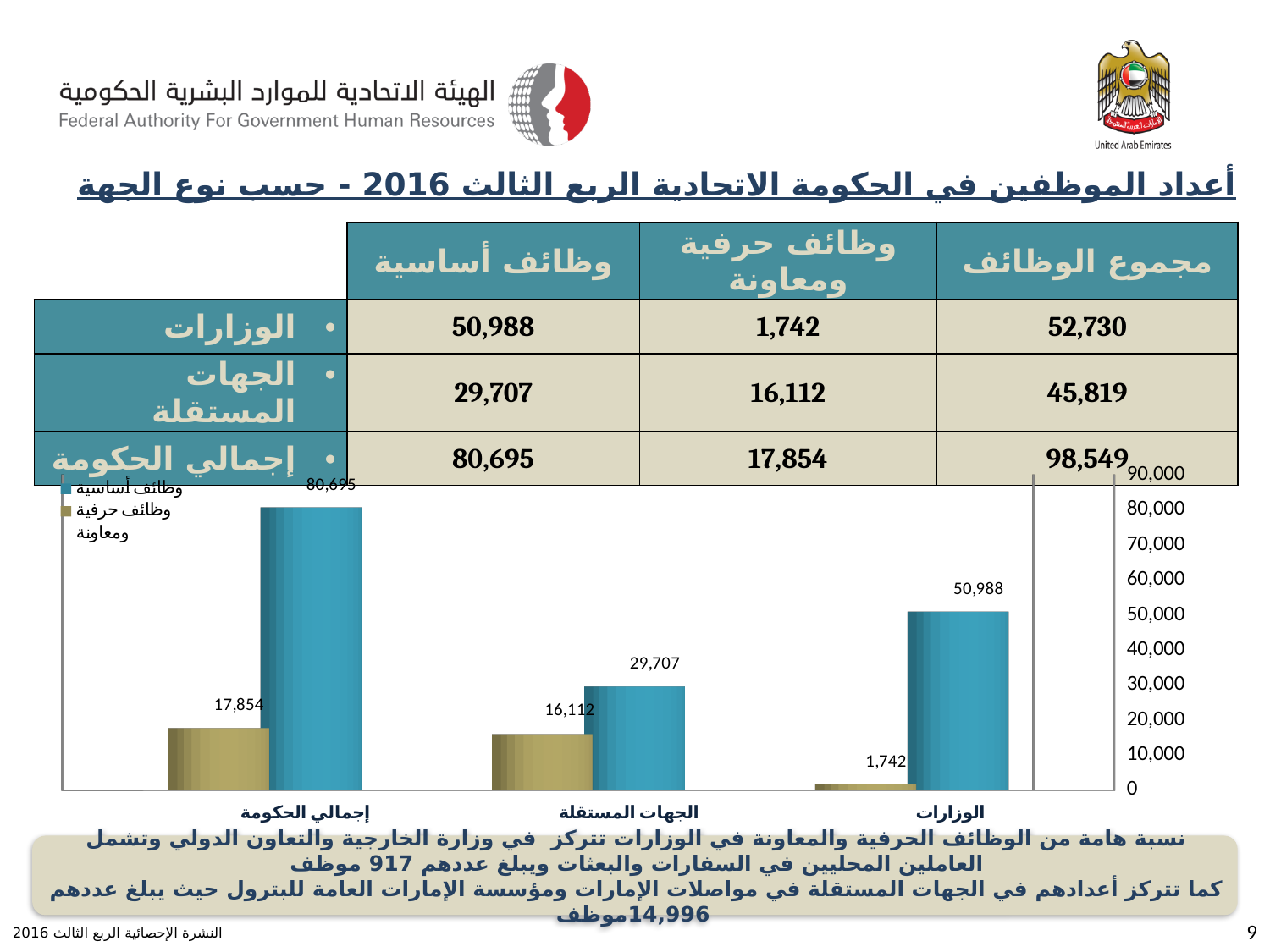
What type of chart is shown on the slide? bar chart What is the value of وظائف حرفية ومعاونة for الوزارات in the chart? 1,742 What is the value of وظائف حرفية ومعاونة for إجمالي الحكومة in the chart? 17,854 What is the value of وظائف أساسية for الوزارات in the chart? 50,988 How many series does the chart legend list? 2 Which category has the lowest value for وظائف حرفية ومعاونة in the chart? الوزارات In the chart, is the value of وظائف حرفية ومعاونة for الجهات المستقلة larger or smaller than that for إجمالي الحكومة? smaller Is the value of وظائف أساسية for إجمالي الحكومة greater or less than 80,000? greater What is the value of وظائف أساسية for الجهات المستقلة in the chart? 29,707 Which category has the highest value for وظائف أساسية in the chart? إجمالي الحكومة What is the difference between وظائف أساسية and وظائف حرفية ومعاونة for الجهات المستقلة in the chart? 13,595 How many categories are shown on the x axis of the chart? 3